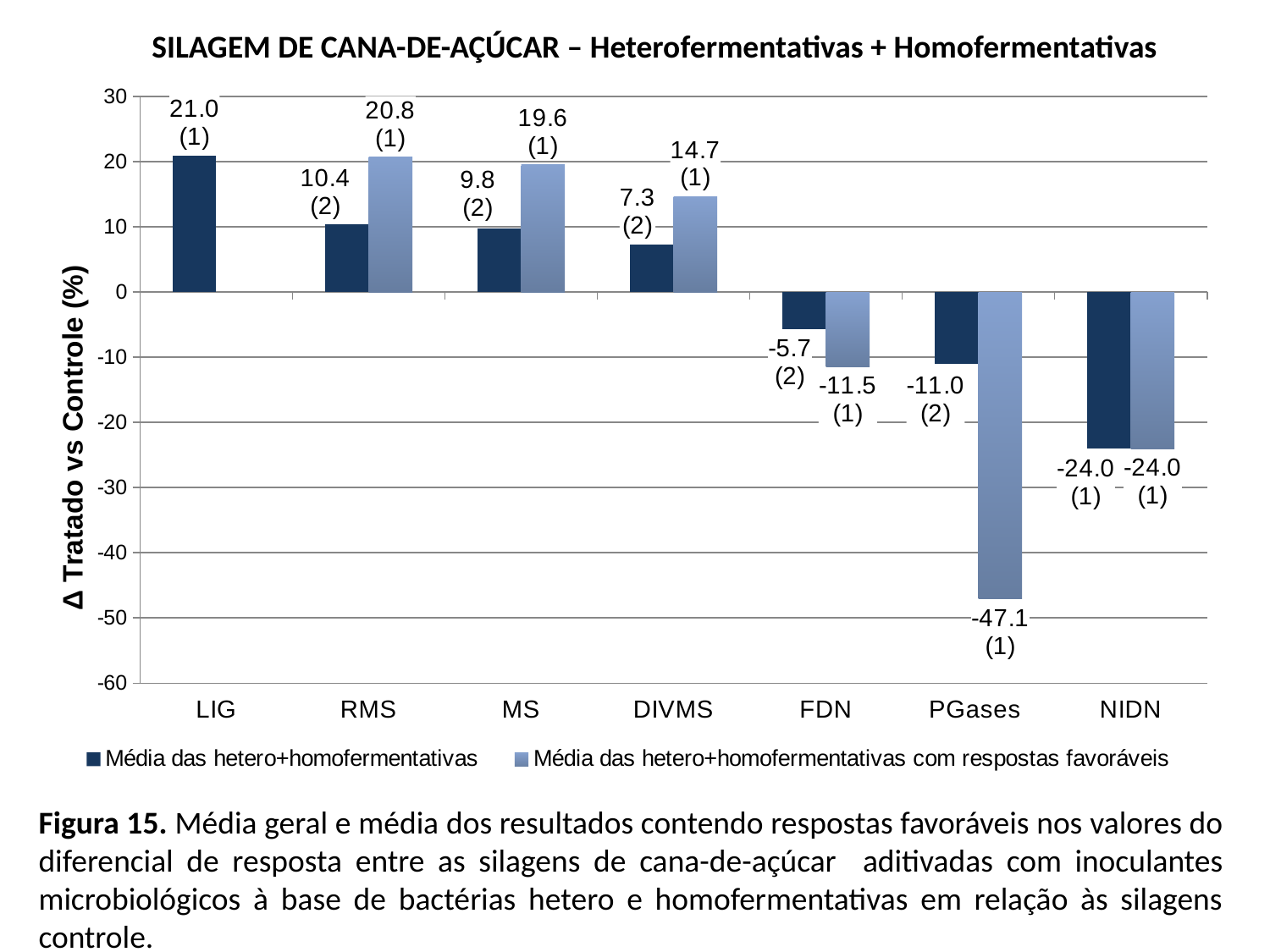
Which category has the lowest value for 'Média das hetero+homofermentativas com respostas favoráveis'? PGases What is the value of 'Média das hetero+homofermentativas com respostas favoráveis' for NIDN? -24.0 What is the label of the y axis? Δ Tratado vs Controle (%) What is the value of 'Média das hetero+homofermentativas com respostas favoráveis' for PGases? -47.1 Which category has the highest value for 'Média das hetero+homofermentativas'? LIG What is the value of 'Média das hetero+homofermentativas' for DIVMS? 7.3 What is the value of 'Média das hetero+homofermentativas' for LIG? 21.0 How many categories are shown on the x axis? 7 What kind of chart is shown on the slide? Bar chart For FDN, which series has the larger value: 'Média das hetero+homofermentativas' or 'Média das hetero+homofermentativas com respostas favoráveis'? Média das hetero+homofermentativas What is the difference between the two series' values for RMS? 10.4 How many series does the legend list? 2